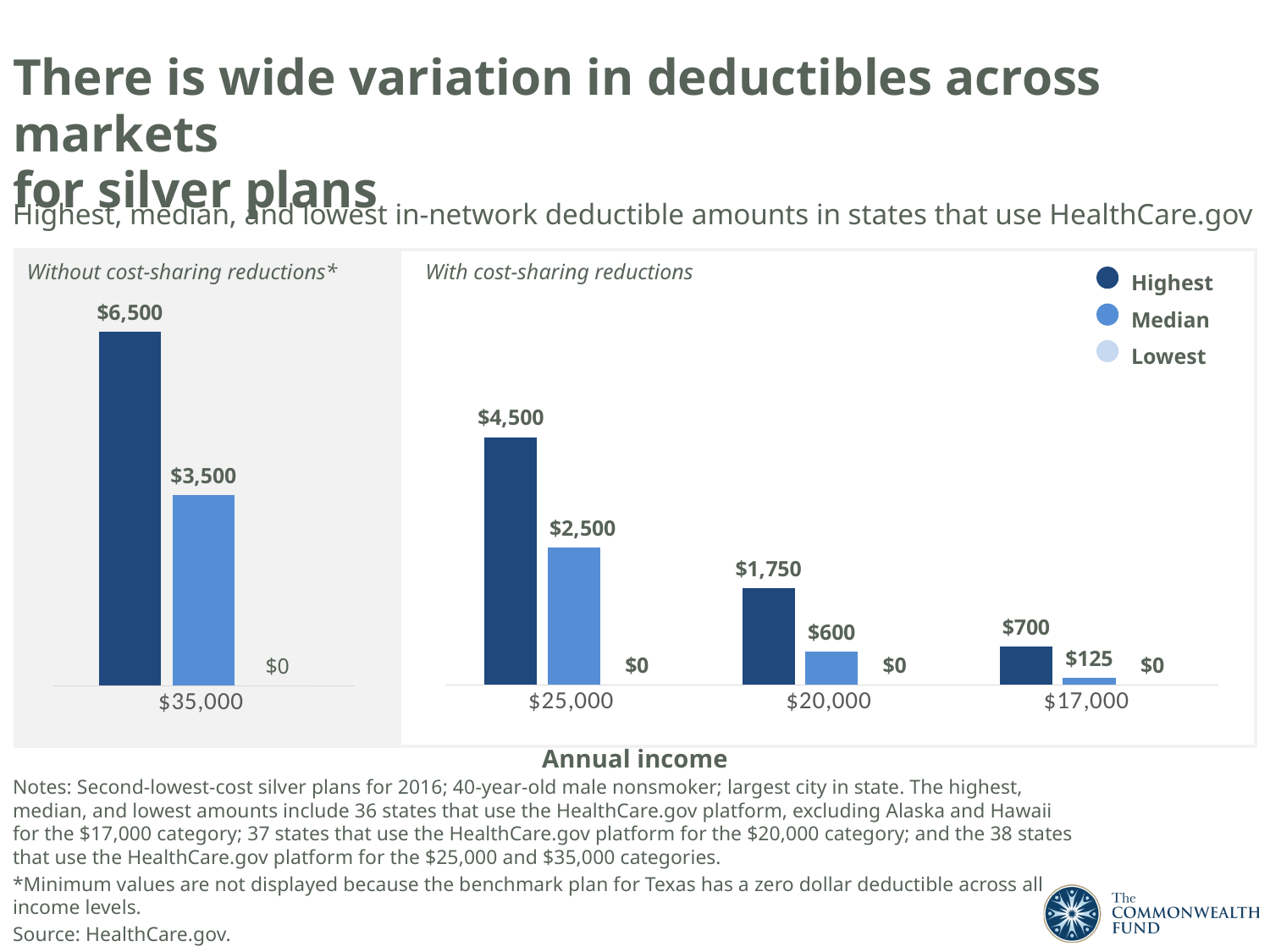
In the 'Without cost-sharing reductions*' chart, what is the Median deductible for the $35,000 income category? $3,500 Is the Highest deductible for the $20,000 income category in the 'With cost-sharing reductions' chart larger or smaller than the Highest deductible for the $17,000 category? larger In the 'With cost-sharing reductions' chart, what is the difference between the Highest and Median deductibles for the $25,000 income category? $2,000 How many series does the legend list? 3 In the 'With cost-sharing reductions' chart, what is the Median deductible for the $20,000 income category? $600 In the 'With cost-sharing reductions' chart, what is the Median deductible for the $17,000 income category? $125 How many income categories are shown in the 'With cost-sharing reductions' chart? 3 In the 'With cost-sharing reductions' chart, do the Highest deductibles rise or fall as you move from $25,000 to $17,000 along the x axis? fall In the 'Without cost-sharing reductions*' chart, what is the difference between the Highest and Median deductibles for the $35,000 income category? $3,000 In the 'With cost-sharing reductions' chart, which income category has the highest value for the Highest series? $25,000 In the 'With cost-sharing reductions' chart, which income category has the lowest Median deductible? $17,000 In the 'With cost-sharing reductions' chart, what is the Highest deductible for the $25,000 income category? $4,500